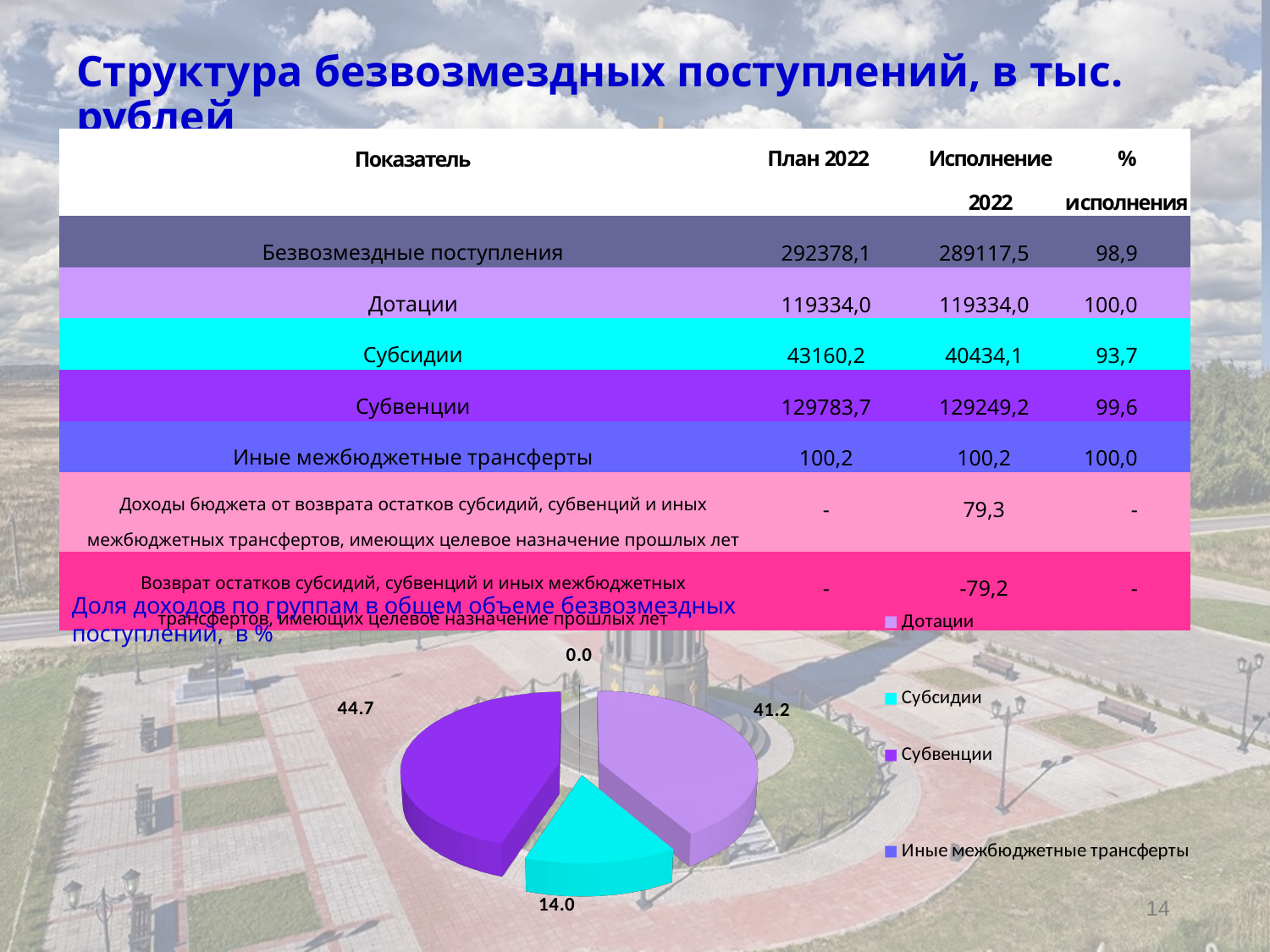
Which category has the largest share in the pie chart? Субвенции What is the share of Субвенции in the pie chart? 44.7 What kind of chart is shown on the slide? pie chart Which category has the smallest share in the pie chart? Иные межбюджетные трансферты What is the share of Дотации in the pie chart? 41.2 What is the difference between the shares of Субвенции and Дотации in the pie chart? 3.5 What is the title of the pie chart? Доля доходов по группам в общем объеме безвозмездных поступлений, в % What is the share of Субсидии in the pie chart? 14.0 How many entries does the legend of the pie chart list? 4 Which has a larger share in the pie chart, Дотации or Субсидии? Дотации What is the share of Иные межбюджетные трансферты in the pie chart? 0.0 What is the difference between the shares of Дотации and Субсидии in the pie chart? 27.2